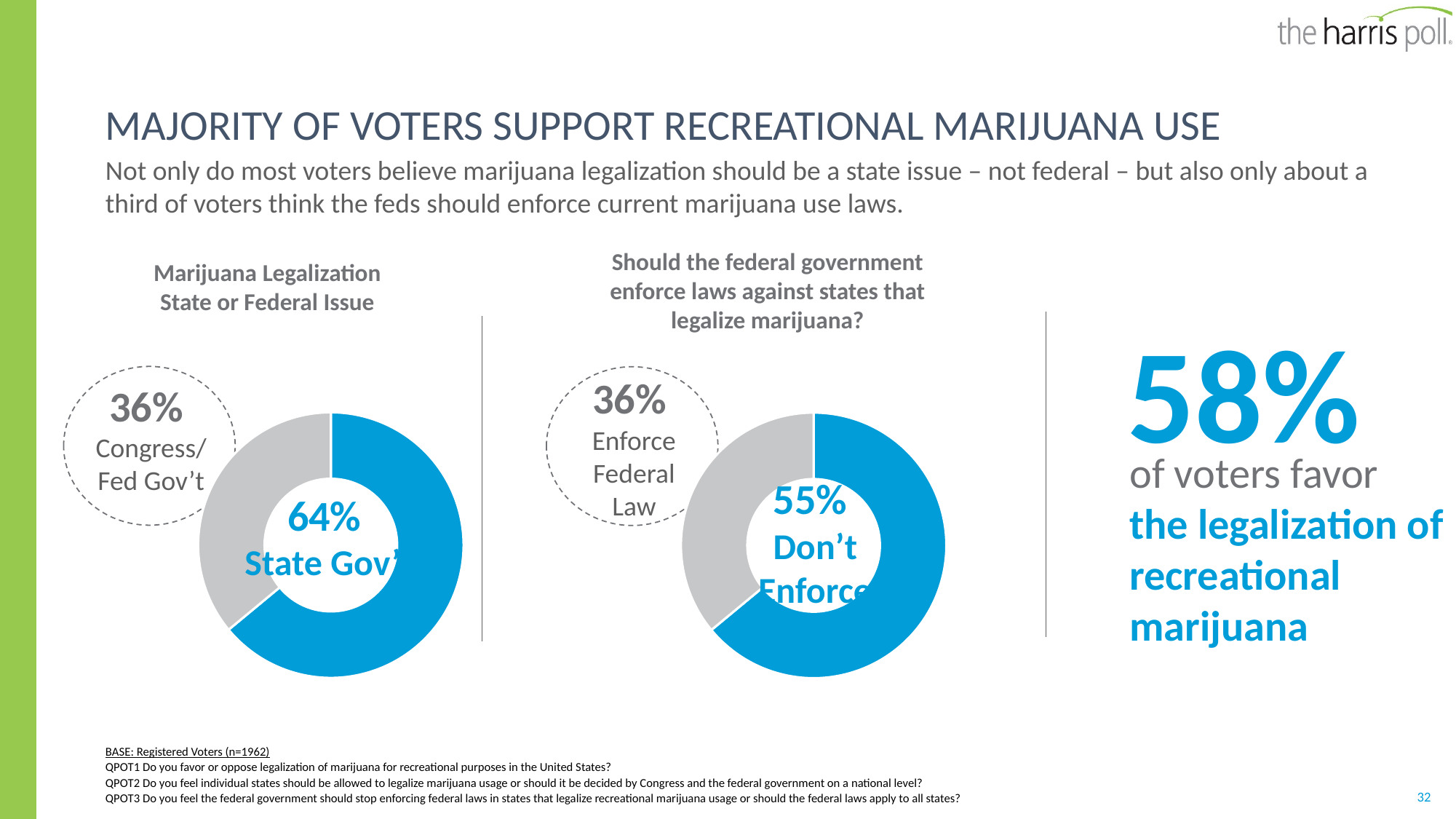
In the 'Marijuana Legalization State or Federal Issue' chart, which slice is the largest? State Gov't In the 'Should the federal government enforce laws against states that legalize marijuana?' chart, which is larger: Don't Enforce or Enforce Federal Law? Don't Enforce In the 'Should the federal government enforce laws against states that legalize marijuana?' chart, what colour is the Don't Enforce slice? Blue How many slices does the 'Marijuana Legalization State or Federal Issue' chart have? 2 What type of chart is the 'Marijuana Legalization State or Federal Issue' chart? Donut (pie) chart In the 'Marijuana Legalization State or Federal Issue' chart, how many percentage points larger is State Gov't than Congress/Fed Gov't? 28 In the 'Should the federal government enforce laws against states that legalize marijuana?' chart, what share of voters said Don't Enforce? 55% In the 'Should the federal government enforce laws against states that legalize marijuana?' chart, what share of voters said Enforce Federal Law? 36% In the 'Marijuana Legalization State or Federal Issue' chart, what share of voters chose Congress/Fed Gov't? 36% In the 'Should the federal government enforce laws against states that legalize marijuana?' chart, what is the difference in percentage points between Don't Enforce and Enforce Federal Law? 19 In the 'Marijuana Legalization State or Federal Issue' chart, what share of voters chose State Gov't? 64% In the 'Should the federal government enforce laws against states that legalize marijuana?' chart, which slice is the smallest? Enforce Federal Law